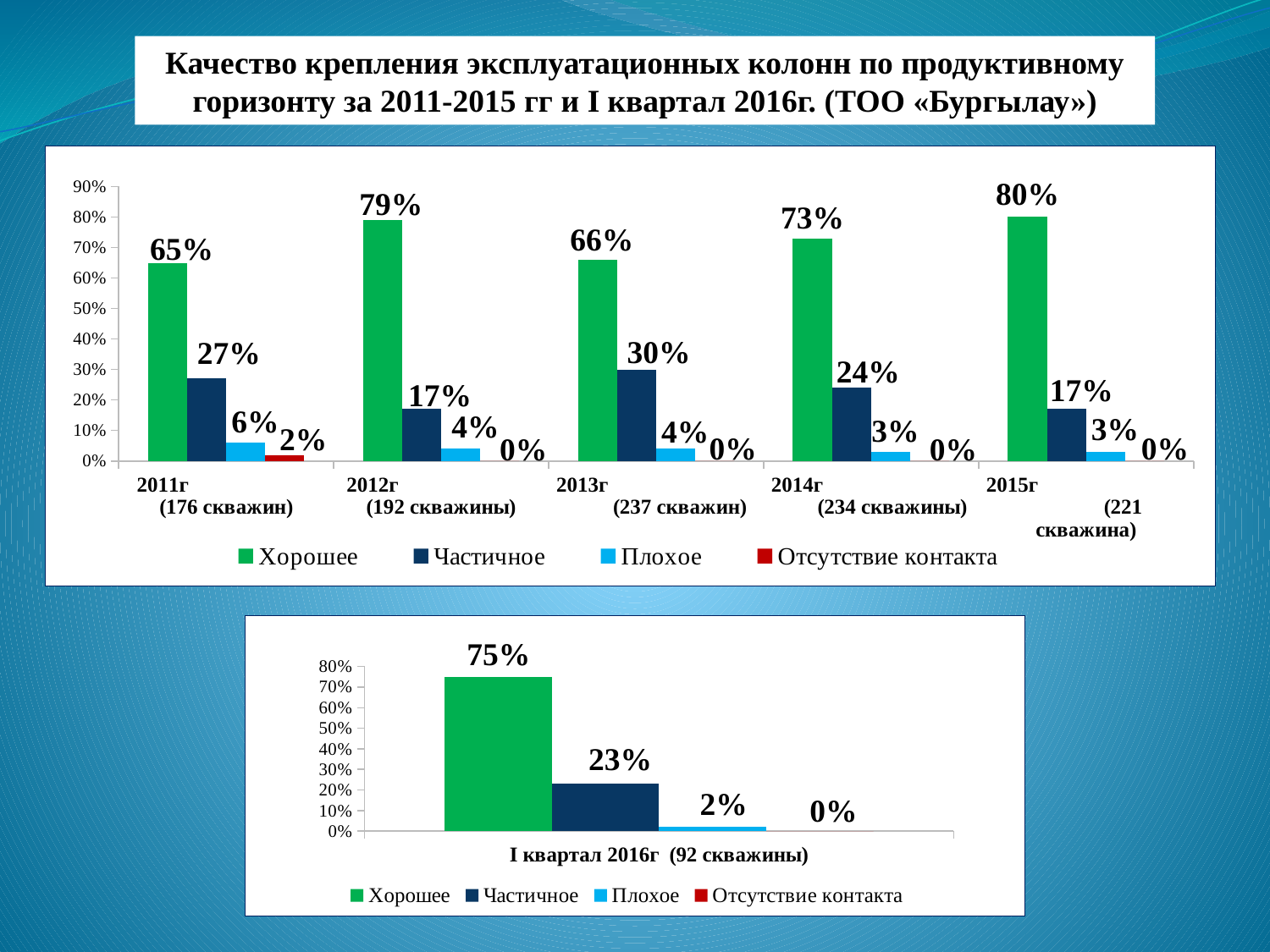
In the top chart, which is larger: Частичное for 2011г or Частичное for 2014г? Частичное for 2011г How many series does the legend of the top chart list? 4 In the bottom chart, what is the value of Частичное for I квартал 2016г? 23% In the top chart, what is the value of Хорошее for 2012г? 79% In the top chart, which year has the highest Хорошее value? 2015г What type of chart is the bottom chart? Bar chart In the top chart, what is the value of Отсутствие контакта for 2011г? 2% In the bottom chart, what is the value of Плохое for I квартал 2016г? 2% In the top chart, which year has the lowest Хорошее value? 2011г In the top chart, what is the value of Частичное for 2013г? 30% In the top chart, what is the difference between the Хорошее values for 2015г and 2011г? 15% How many year categories are shown on the x axis of the top chart? 5